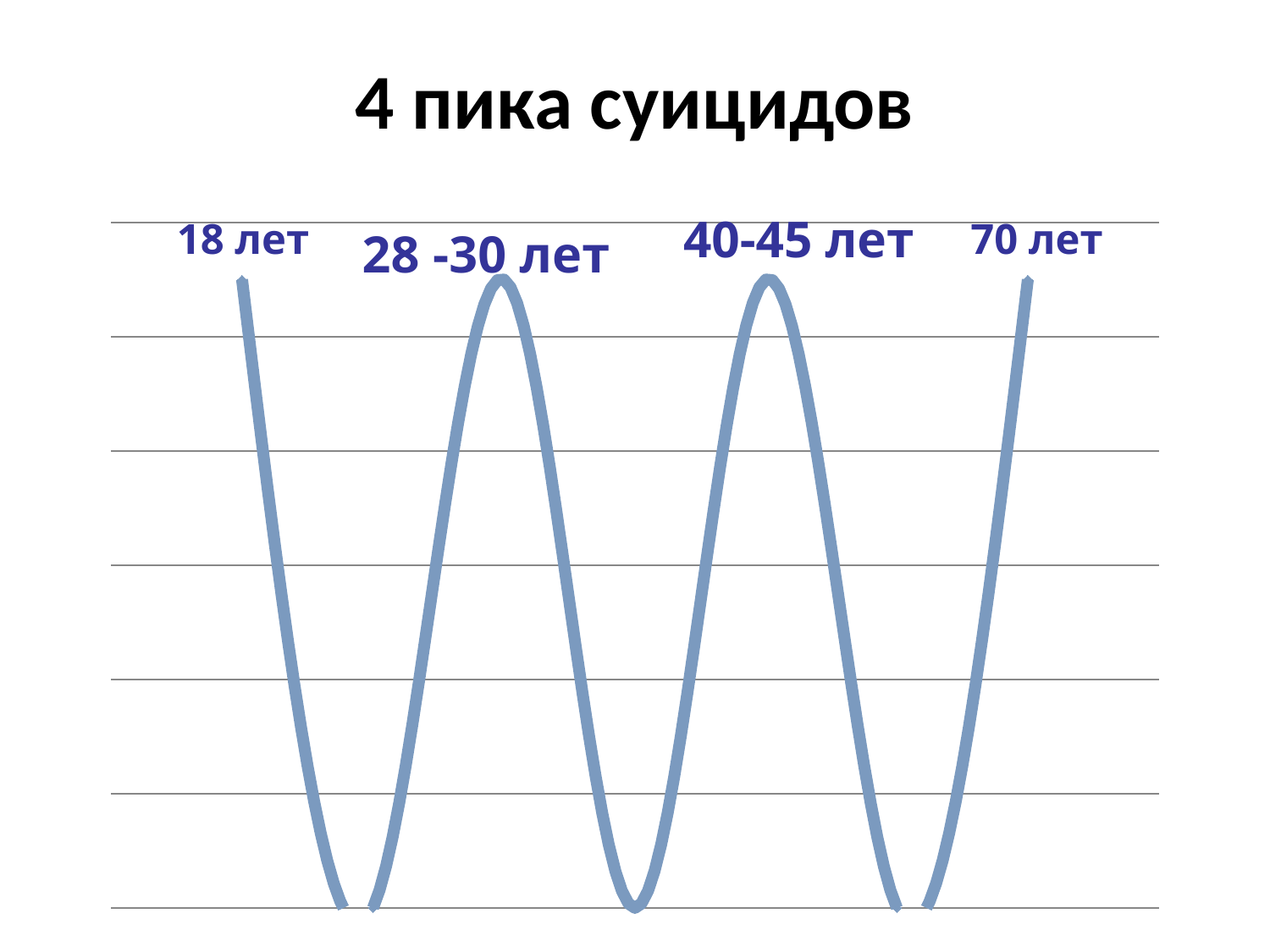
How many data series are plotted on the chart? 1 Does the line rise or fall as it approaches the peak labelled 70 лет? rise What is the title of the chart on the slide? 4 пика суицидов Which age label is attached to the second peak of the chart? 28 -30 лет Which age label is attached to the last peak on the right of the chart? 70 лет Does the line rise or fall immediately after the peak labelled 18 лет? fall Which age label is attached to the first peak on the left of the chart? 18 лет What colour is the line plotted on the chart? blue What kind of chart is shown on the slide? line chart How many peaks are labelled on the chart? 4 Which age label is attached to the third peak of the chart? 40-45 лет